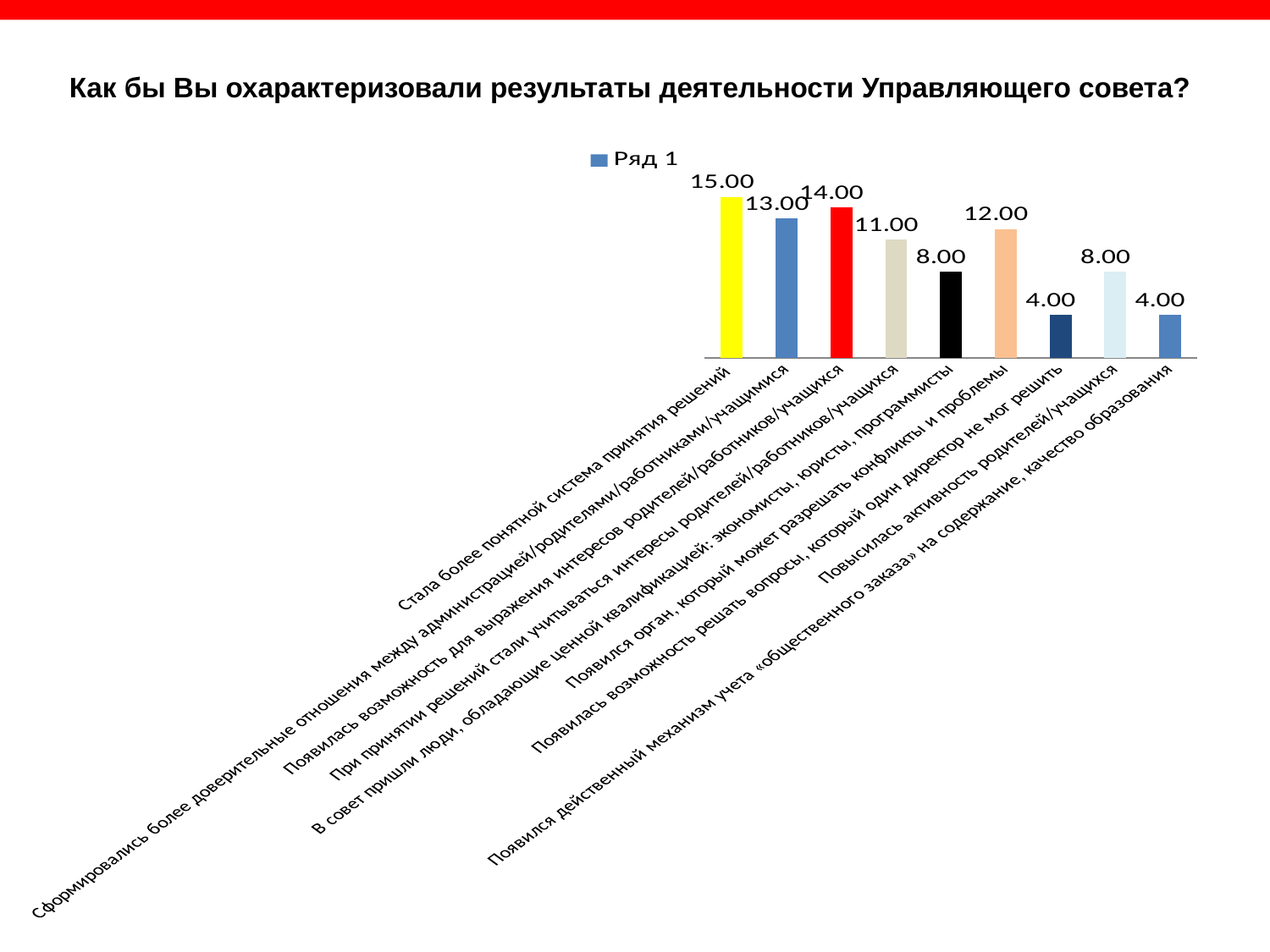
What is the name of the series in the legend? Ряд 1 How many categories are shown on the chart? 9 What value is shown for «Повысилась активность родителей/учащихся»? 8.00 What value is shown for «При принятии решений стали учитываться интересы родителей/работников/учащихся»? 11.00 What value is shown for «Появился орган, который может разрешать конфликты и проблемы»? 12.00 Which category has the highest value? Стала более понятной система принятия решений What kind of chart is shown on the slide? Bar chart How many series does the legend list? 1 What is the difference between the values for «Стала более понятной система принятия решений» and «Появилась возможность решать вопросы, который один директор не мог решить»? 11.00 Which is larger: the value for «Сформировались более доверительные отношения между администрацией/родителями/работниками/учащимися» or for «Появилась возможность для выражения интересов родителей/работников/учащихся»? Появилась возможность для выражения интересов родителей/работников/учащихся What value is shown for «Стала более понятной система принятия решений»? 15.00 What is the lowest value shown on the chart? 4.00